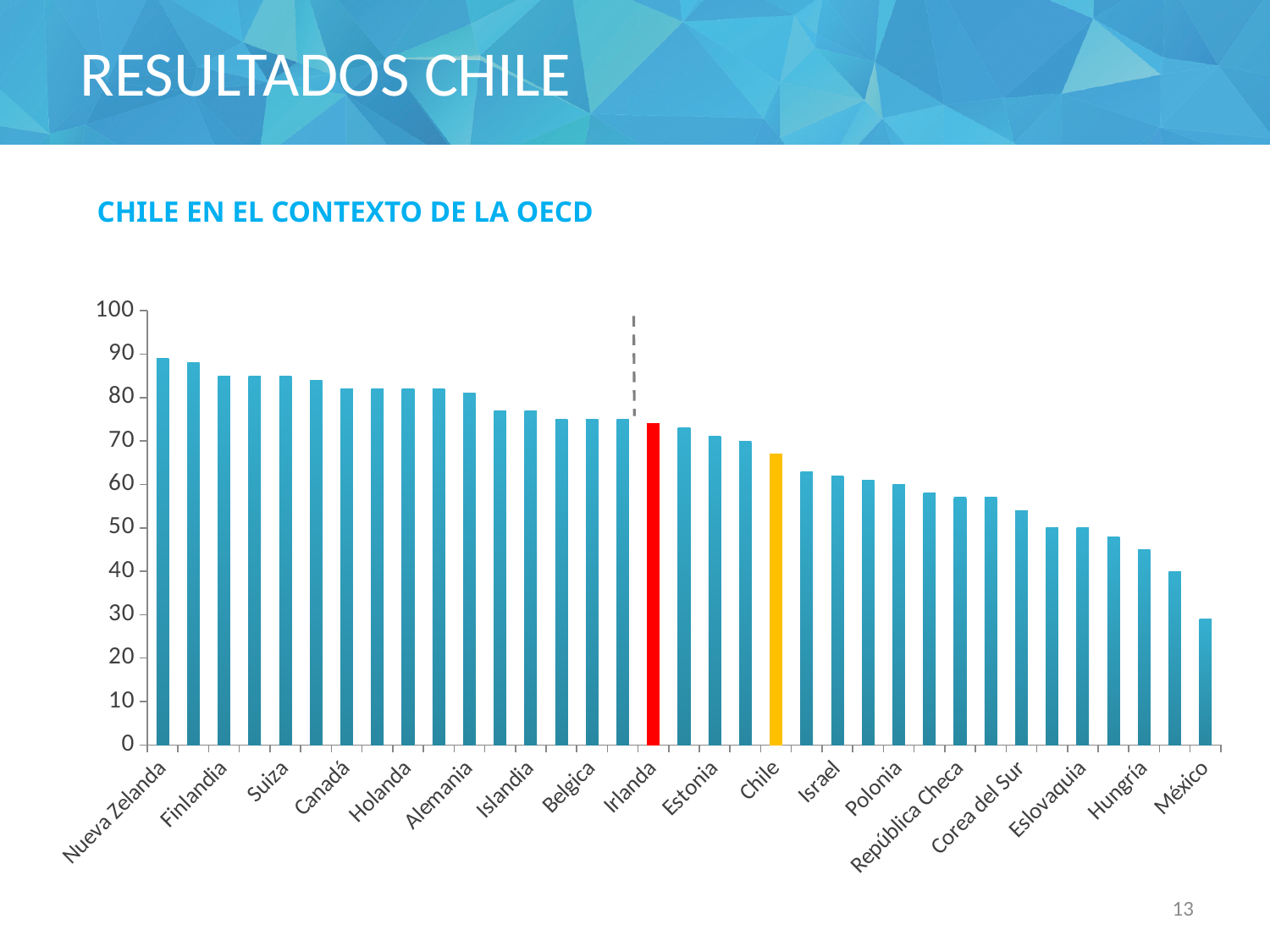
Is the value for Polonia greater or less than 50? greater What kind of chart is shown on the slide? bar chart Which has the larger value, Chile or Hungría? Chile Which has the larger value, Chile or Irlanda? Irlanda What is the title shown above the chart? CHILE EN EL CONTEXTO DE LA OECD Do the values rise or fall moving from left to right along the x axis? fall Is the value for Chile greater or less than 60? greater Is the value for Hungría greater or less than 50? less Which country has the lowest value in the chart? México What colour is the bar for Chile? yellow